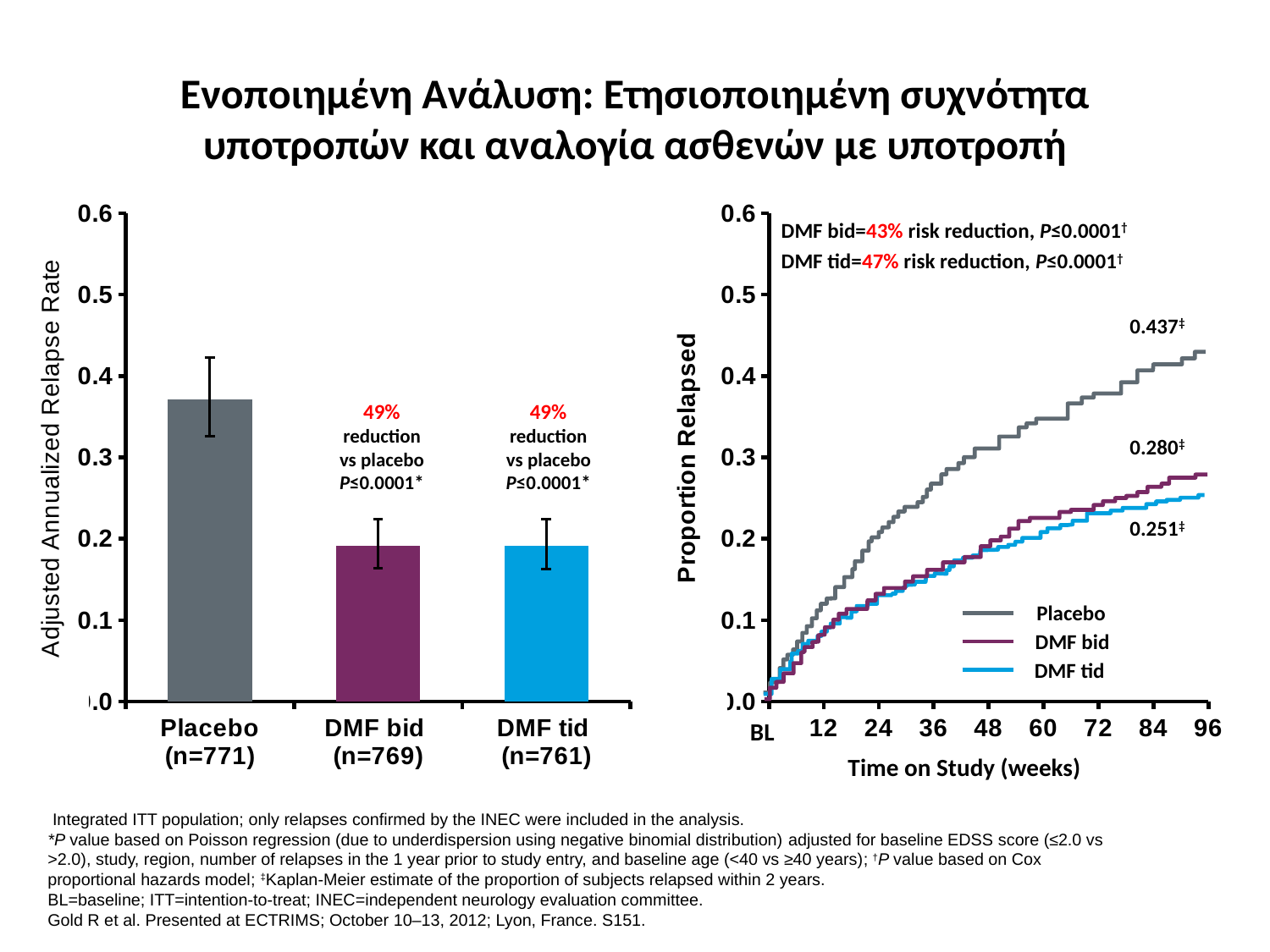
How many series does the legend of the right chart list? 3 In the right chart, does the proportion relapsed rise or fall as time on study increases? rise In the left chart, which group has the highest adjusted annualized relapse rate? Placebo In the right chart (Proportion Relapsed), what is the final labelled value for Placebo? 0.437 In the left chart, what percentage reduction vs placebo is shown for DMF bid? 49% How many treatment groups are shown as bars in the left chart? 3 In the right chart, what is the difference between the final labelled values for Placebo and DMF bid? 0.157 In the right chart (Proportion Relapsed), what is the final labelled value for DMF tid? 0.251 In the left chart, is the value for Placebo greater or less than 0.3? greater In the left chart, is the value for DMF tid greater or less than 0.3? less What kind of chart is the left chart (Adjusted Annualized Relapse Rate)? bar chart What is the x-axis label of the right chart? Time on Study (weeks)